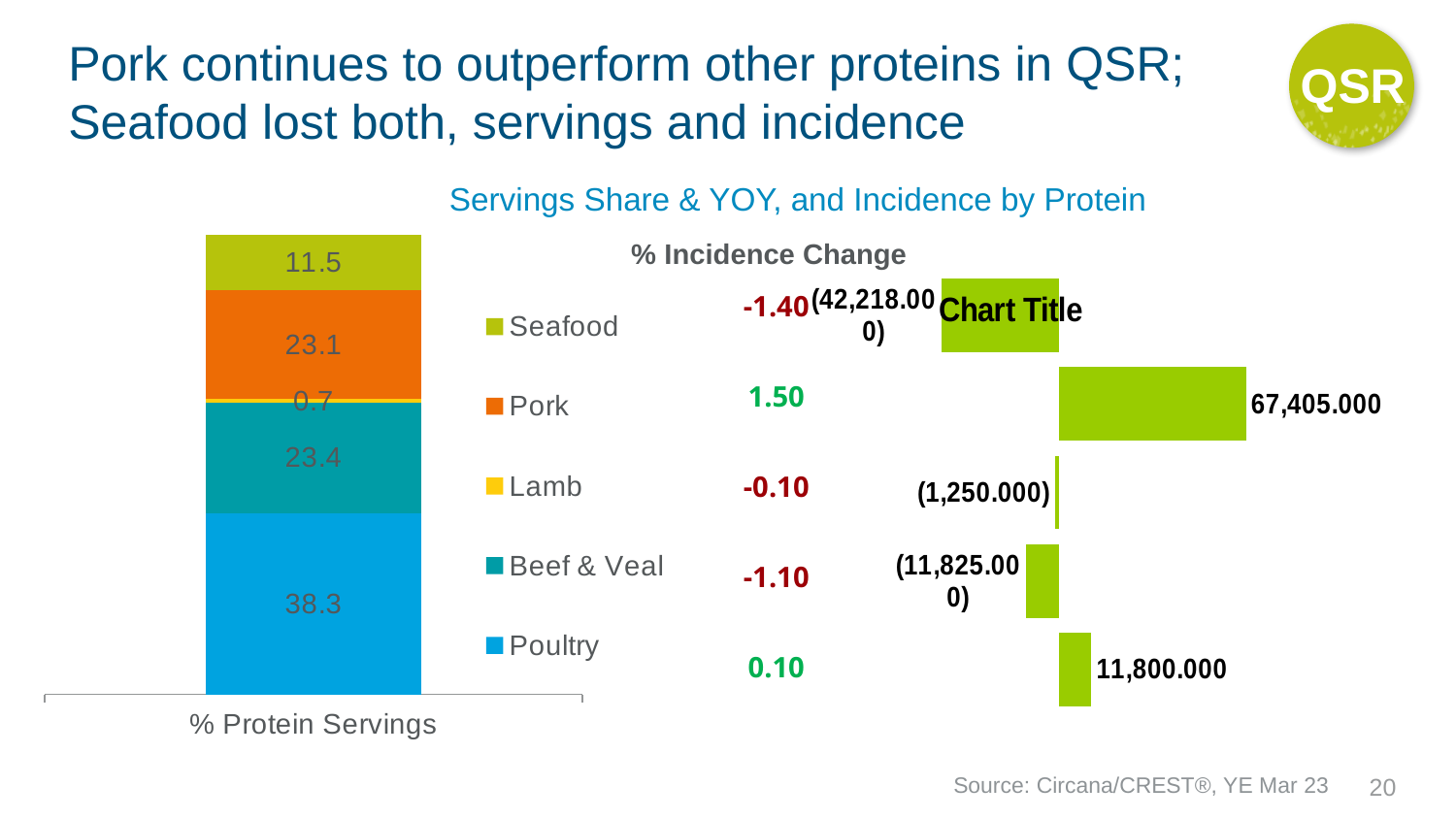
In the stacked bar chart on the left (% Protein Servings), what is the difference between the Poultry and Seafood values? 26.8 What is the % Incidence Change for Pork? 1.50 How many proteins does the legend list? 5 What is the % Incidence Change for Seafood? -1.40 In the bar chart on the right labelled 'Chart Title', what is the value for Beef & Veal? (11,825.000) In the stacked bar chart on the left (% Protein Servings), what is the value for Lamb? 0.7 In the bar chart on the right labelled 'Chart Title', what is the value for Pork? 67,405.000 In the stacked bar chart on the left (% Protein Servings), what is the value for Poultry? 38.3 In the stacked bar chart on the left (% Protein Servings), which protein has the smallest share? Lamb In the stacked bar chart on the left (% Protein Servings), what is the value for Pork? 23.1 What kind of chart is the chart on the left showing % Protein Servings? Stacked bar chart In the stacked bar chart on the left (% Protein Servings), which protein has the largest share? Poultry